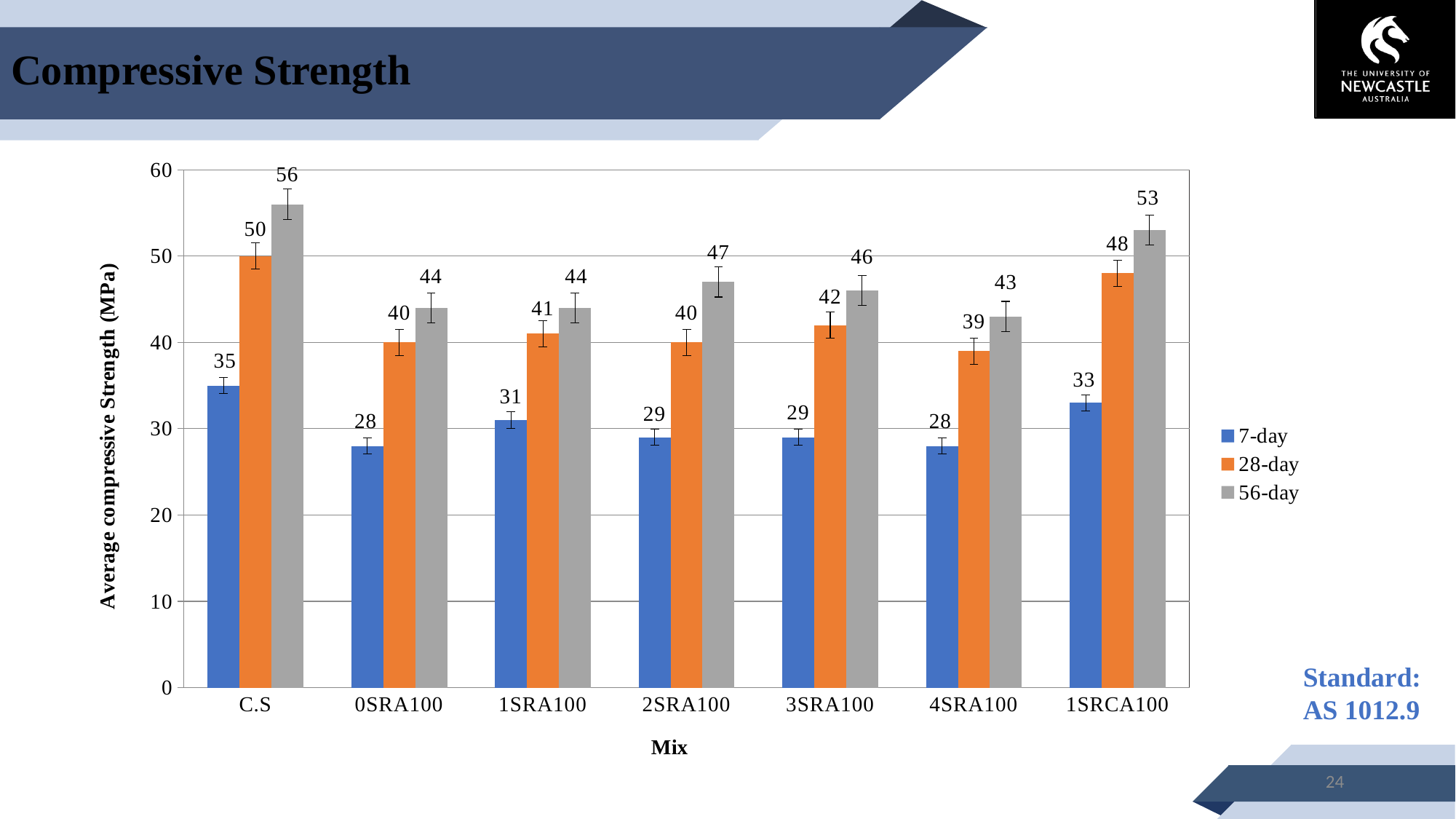
How many mixes are shown on the x axis? 7 Which is larger: the 28-day strength of 1SRCA100 or the 28-day strength of C.S? C.S How many series does the legend list? 3 What kind of chart is shown on the slide? Bar chart What is the label of the y axis? Average compressive Strength (MPa) What is the difference between the 56-day and 7-day compressive strength for the 2SRA100 mix? 18 What is the 7-day average compressive strength for the 1SRCA100 mix? 33 Which mix has the highest 56-day compressive strength? C.S What is the 28-day average compressive strength for the 3SRA100 mix? 42 What is the 56-day average compressive strength for the C.S mix? 56 Which mix has the lowest 28-day compressive strength? 4SRA100 Which colour represents the 56-day series in the legend? Grey